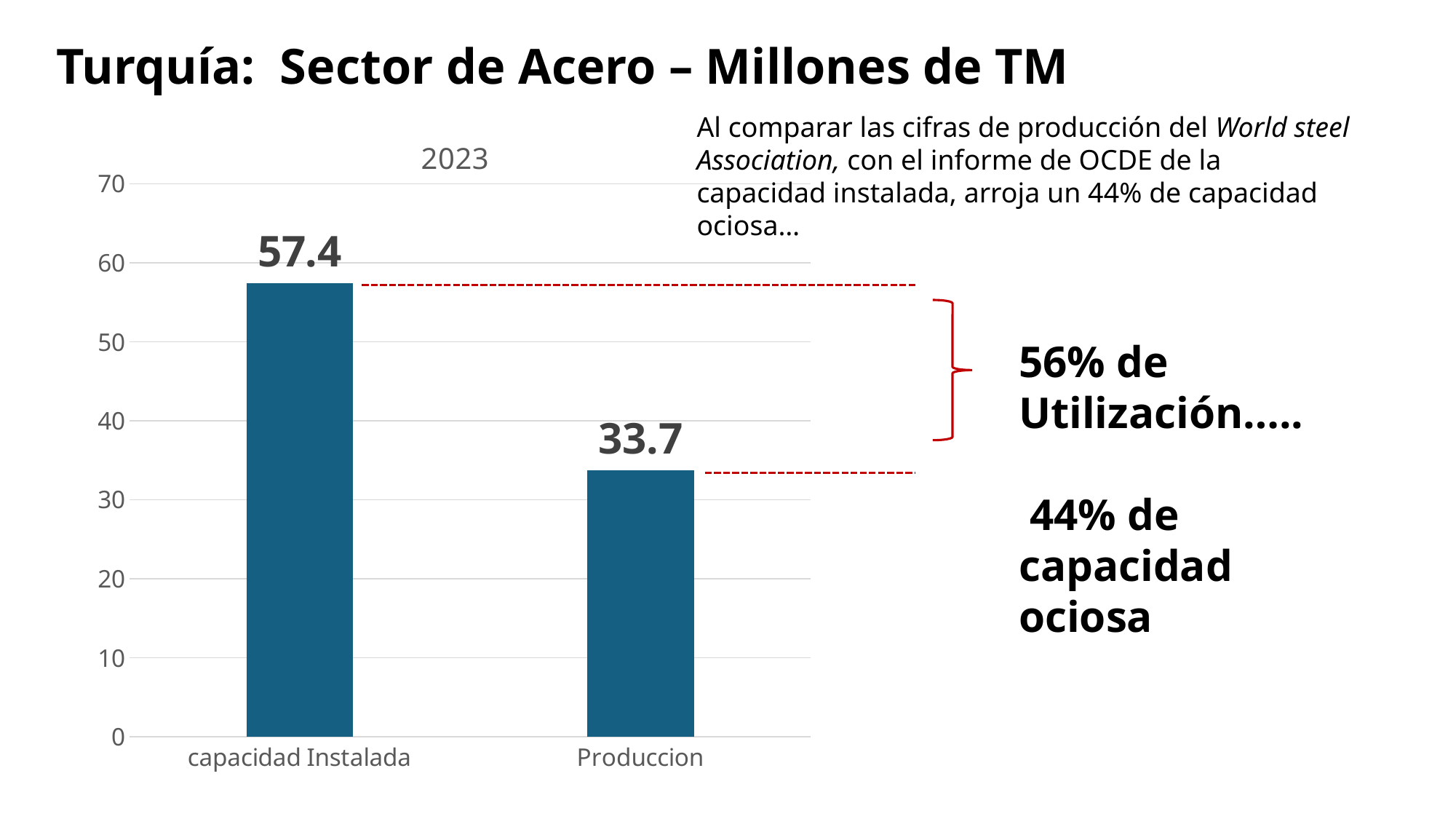
What is the value for Produccion? 33.7 What is the difference between capacidad Instalada and Produccion? 23.7 Which category has the lowest value? Produccion What kind of chart is shown? bar chart Which is larger, capacidad Instalada or Produccion? capacidad Instalada What is the highest value shown on the y axis? 70 Which category has the highest value? capacidad Instalada How many categories are shown on the x axis? 2 Is the value for Produccion greater or less than 40? less Is the value for capacidad Instalada greater or less than 50? greater What is the title of the chart? 2023 What is the value for capacidad Instalada? 57.4